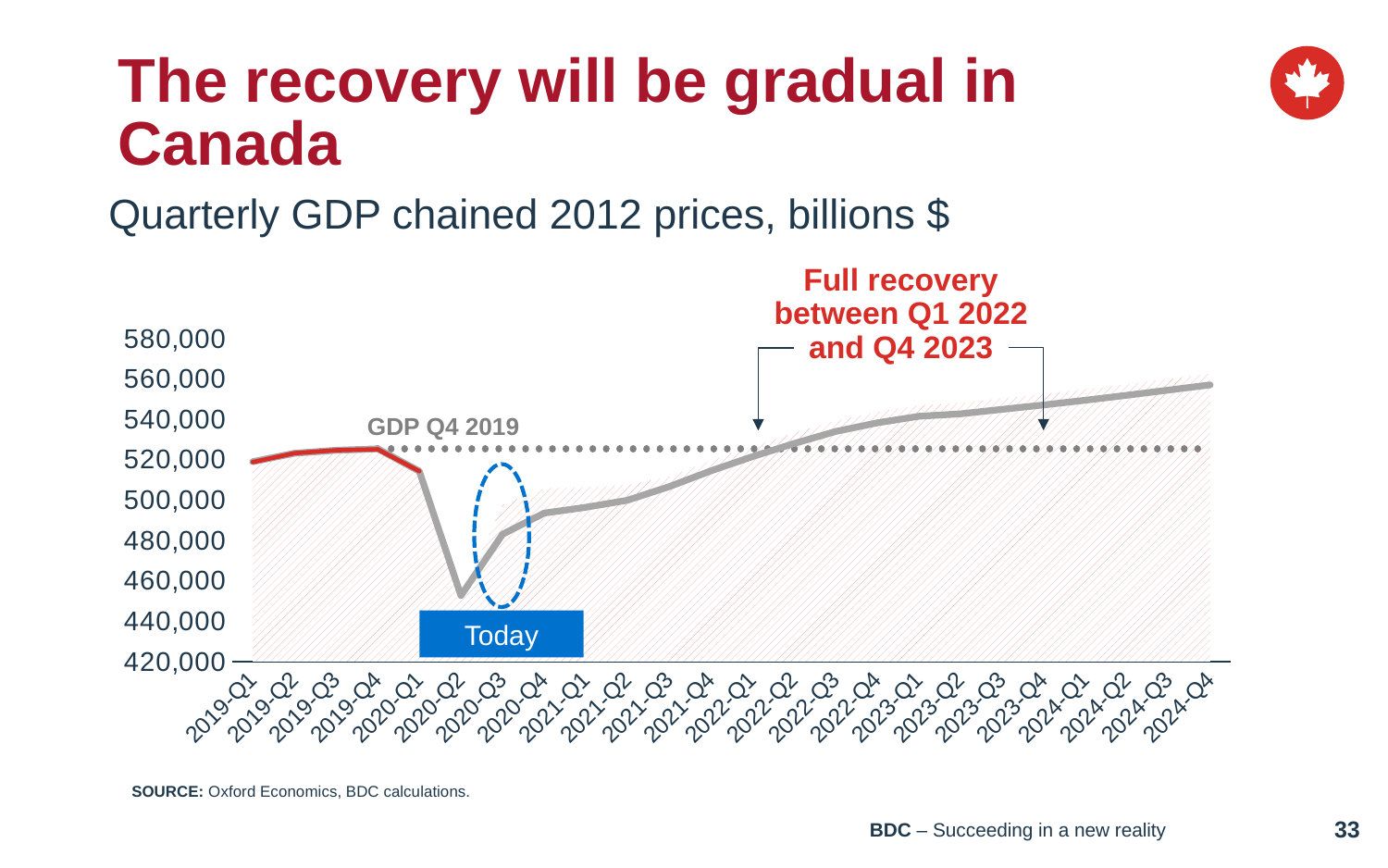
Which is larger, the value for 2020-Q1 or the value for 2020-Q2? 2020-Q1 Is the value for 2024-Q4 greater or less than 540,000? greater Is the value for 2020-Q2 greater or less than 460,000? less Which quarter has the lowest GDP value in the chart? 2020-Q2 According to the annotation on the chart, between which quarters is full recovery expected? Q1 2022 and Q4 2023 Do the values rise or fall from 2020-Q2 to 2024-Q4? rise Is the value for 2020-Q3 greater or less than 460,000? greater What kind of chart is shown on the slide? line chart How many quarters are shown on the x axis of the chart? 24 Which quarter has the highest GDP value in the chart? 2024-Q4 What does the horizontal dotted line in the chart represent, according to its label? GDP Q4 2019